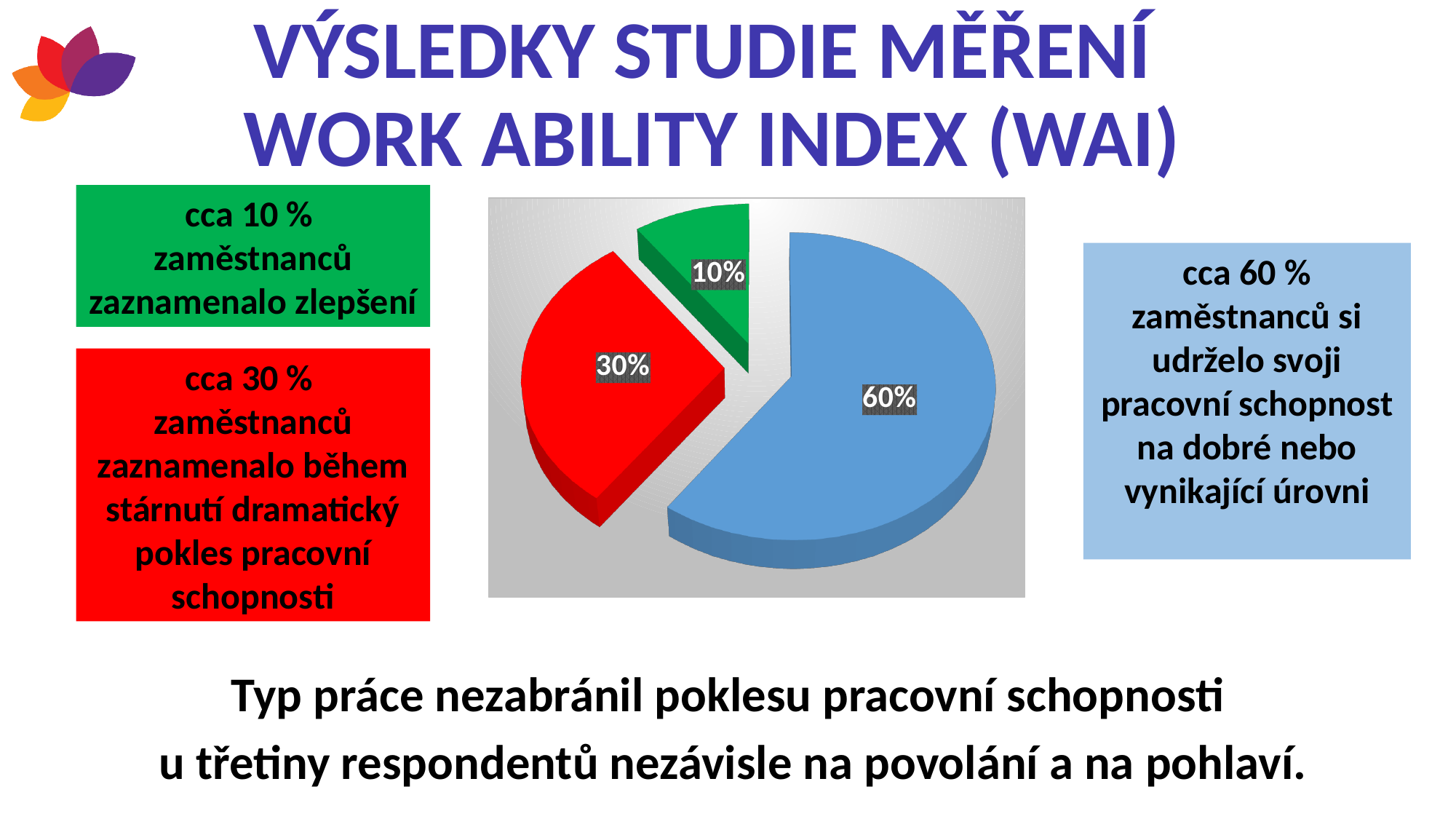
Which slice of the pie chart is the smallest? the green slice (10%) Which slice of the pie chart is the largest? the blue slice (60%) What share of the pie do the red and green slices make up together? 40% What is the difference between the blue slice and the red slice in the pie chart? 30% What percentage is shown on the green slice of the pie chart? 10% What percentage is shown on the blue slice of the pie chart? 60% What percentage is shown on the red slice of the pie chart? 30% What colour is the slice representing employees who maintained their work ability at a good or excellent level? blue How many slices does the pie chart have? 3 What kind of chart is shown on the slide? pie chart What is the difference between the red slice and the green slice in the pie chart? 20% Which is larger in the pie chart, the red slice or the green slice? the red slice